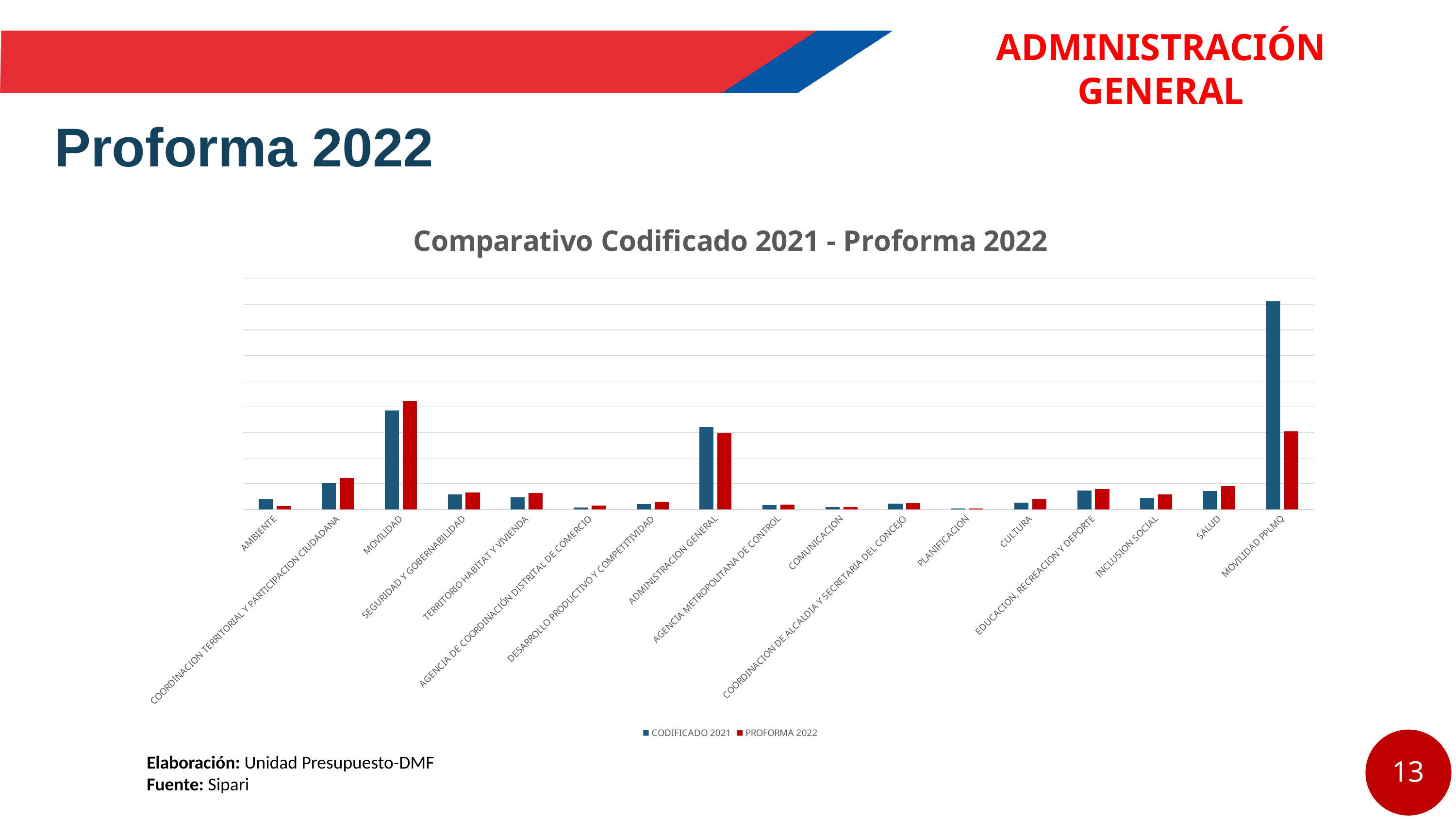
What is the title of the chart? Comparativo Codificado 2021 - Proforma 2022 For MOVILIDAD, which series has the larger value, CODIFICADO 2021 or PROFORMA 2022? PROFORMA 2022 What kind of chart is shown on the slide? Bar chart For AMBIENTE, which series has the larger value, CODIFICADO 2021 or PROFORMA 2022? CODIFICADO 2021 For the PROFORMA 2022 series, which is larger: MOVILIDAD or ADMINISTRACION GENERAL? MOVILIDAD How many series does the chart's legend list? 2 Which category has the highest PROFORMA 2022 value? MOVILIDAD How many categories are shown on the x axis of the chart? 17 Which category has the lowest CODIFICADO 2021 value? PLANIFICACION What are the two series named in the legend? CODIFICADO 2021 and PROFORMA 2022 Which category has the highest CODIFICADO 2021 value? MOVILIDAD PPLMQ